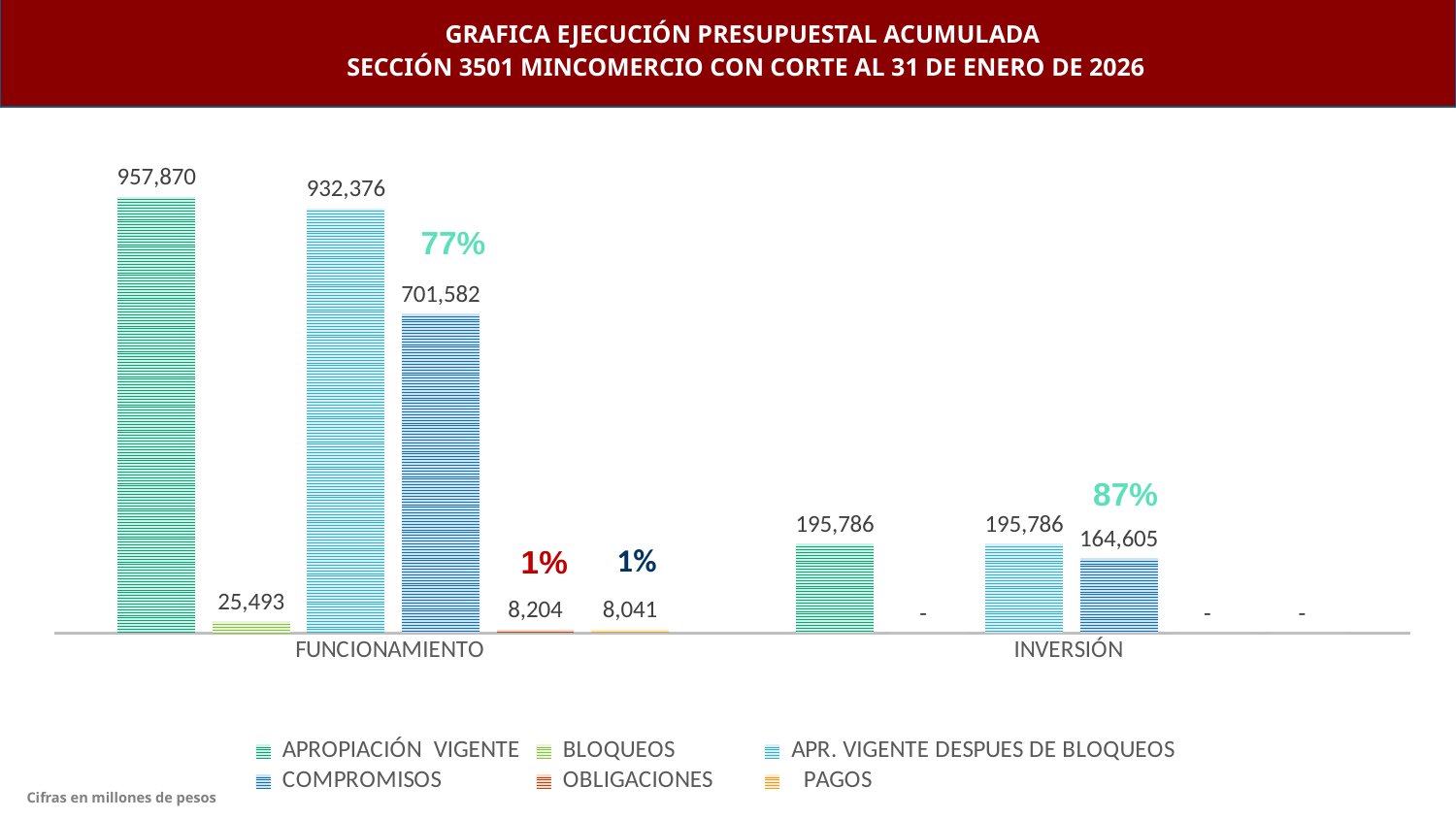
What is the difference between APROPIACIÓN VIGENTE and APR. VIGENTE DESPUES DE BLOQUEOS for FUNCIONAMIENTO? 25,494 Which series has the highest value for FUNCIONAMIENTO? APROPIACIÓN VIGENTE What is the difference between APR. VIGENTE DESPUES DE BLOQUEOS and COMPROMISOS for INVERSIÓN? 31,181 What is the value of PAGOS for FUNCIONAMIENTO? 8,041 What percentage is shown above the COMPROMISOS bar for INVERSIÓN? 87% What is the value of APROPIACIÓN VIGENTE for FUNCIONAMIENTO? 957,870 What is the value of BLOQUEOS for FUNCIONAMIENTO? 25,493 Which is larger: COMPROMISOS for FUNCIONAMIENTO or COMPROMISOS for INVERSIÓN? FUNCIONAMIENTO Which series has the lowest value for FUNCIONAMIENTO? PAGOS What kind of chart is shown on the slide? Bar chart How many series does the legend list? 6 What is the value of COMPROMISOS for INVERSIÓN? 164,605